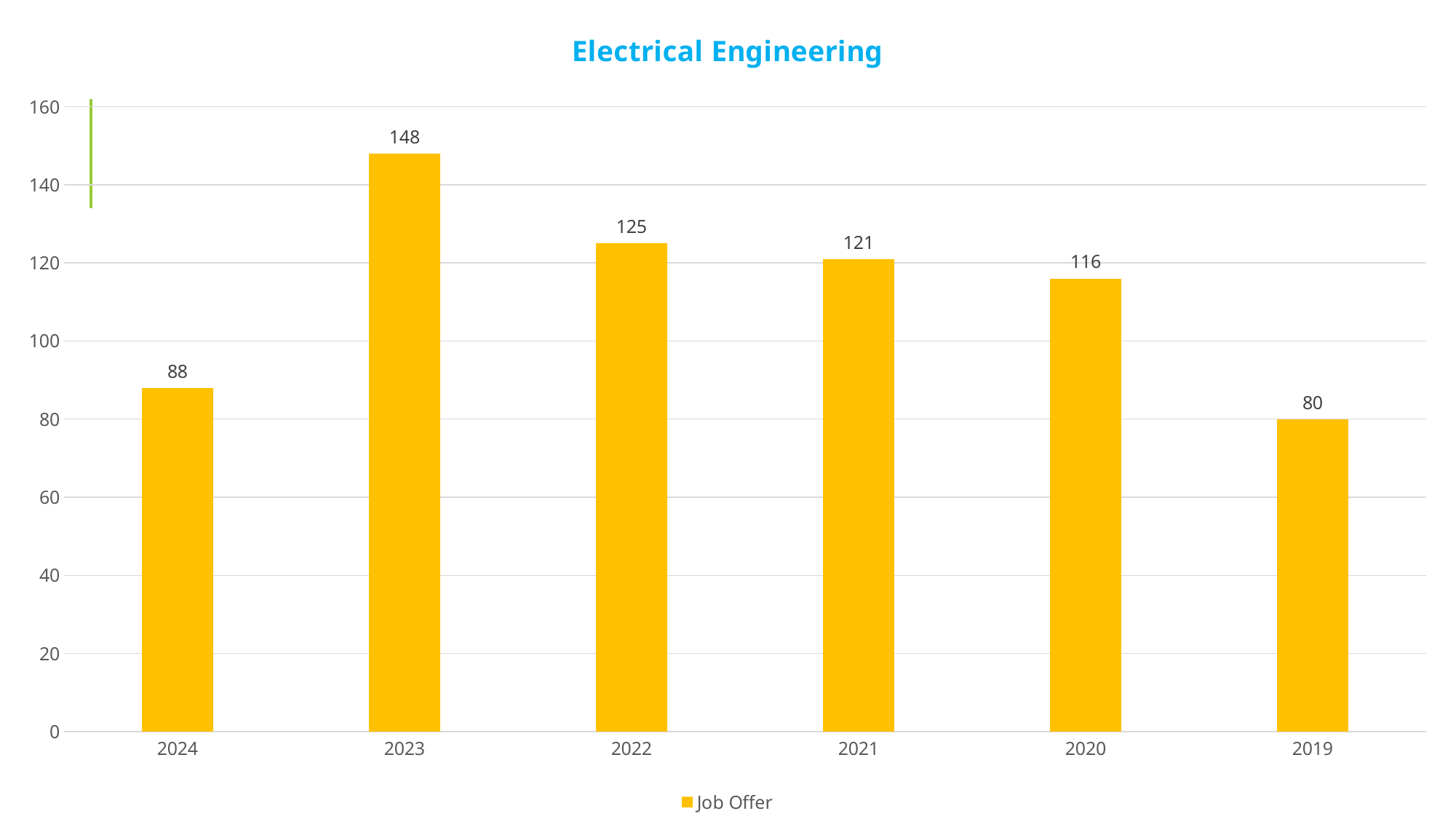
What kind of chart is shown on the slide? bar chart Which year has the lowest Job Offer value? 2019 What is the Job Offer value for 2023? 148 What is the difference between the Job Offer values for 2023 and 2024? 60 What is the Job Offer value for 2021? 121 What is the Job Offer value for 2019? 80 Is the Job Offer value for 2020 greater or less than 100? greater Which is larger, the Job Offer value for 2024 or for 2019? 2024 How many years are shown on the x axis? 6 How many series does the legend list? 1 What is the difference between the Job Offer values for 2022 and 2020? 9 Which year has the highest Job Offer value? 2023